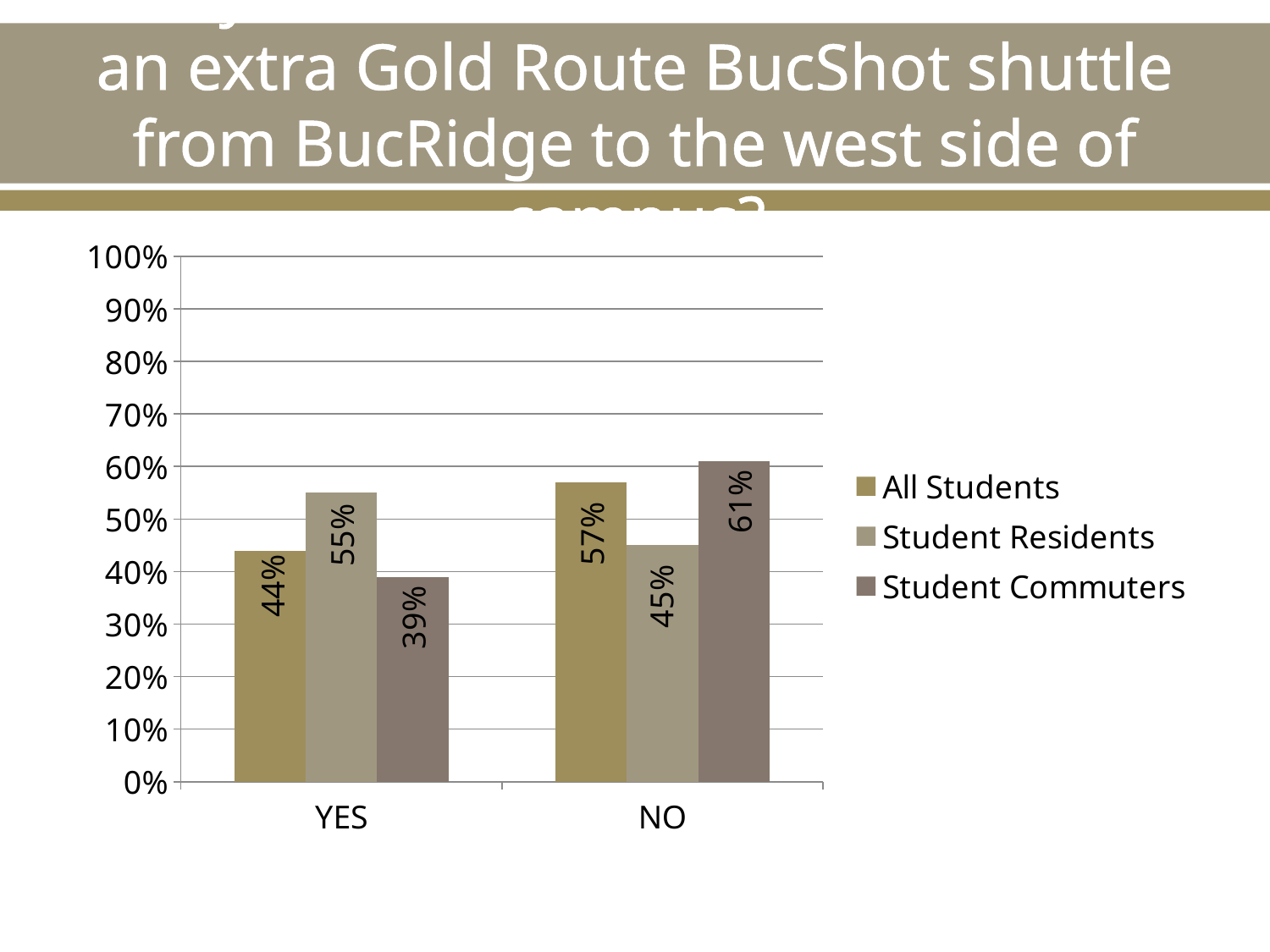
What is the value for Student Residents in the NO category? 45% What is the value for All Students in the YES category? 44% Which series has the lowest value in the YES category? Student Commuters How many categories are shown on the x axis? 2 Is the value for Student Commuters in the YES category greater or less than 40%? less Which series has the highest value in the NO category? Student Commuters How many series does the legend list? 3 Which is larger: the All Students value for YES or for NO? NO What kind of chart is shown on the slide? bar chart What is the value for Student Residents in the YES category? 55% What is the value for Student Commuters in the NO category? 61% What is the difference between the Student Commuters values for NO and YES? 22%